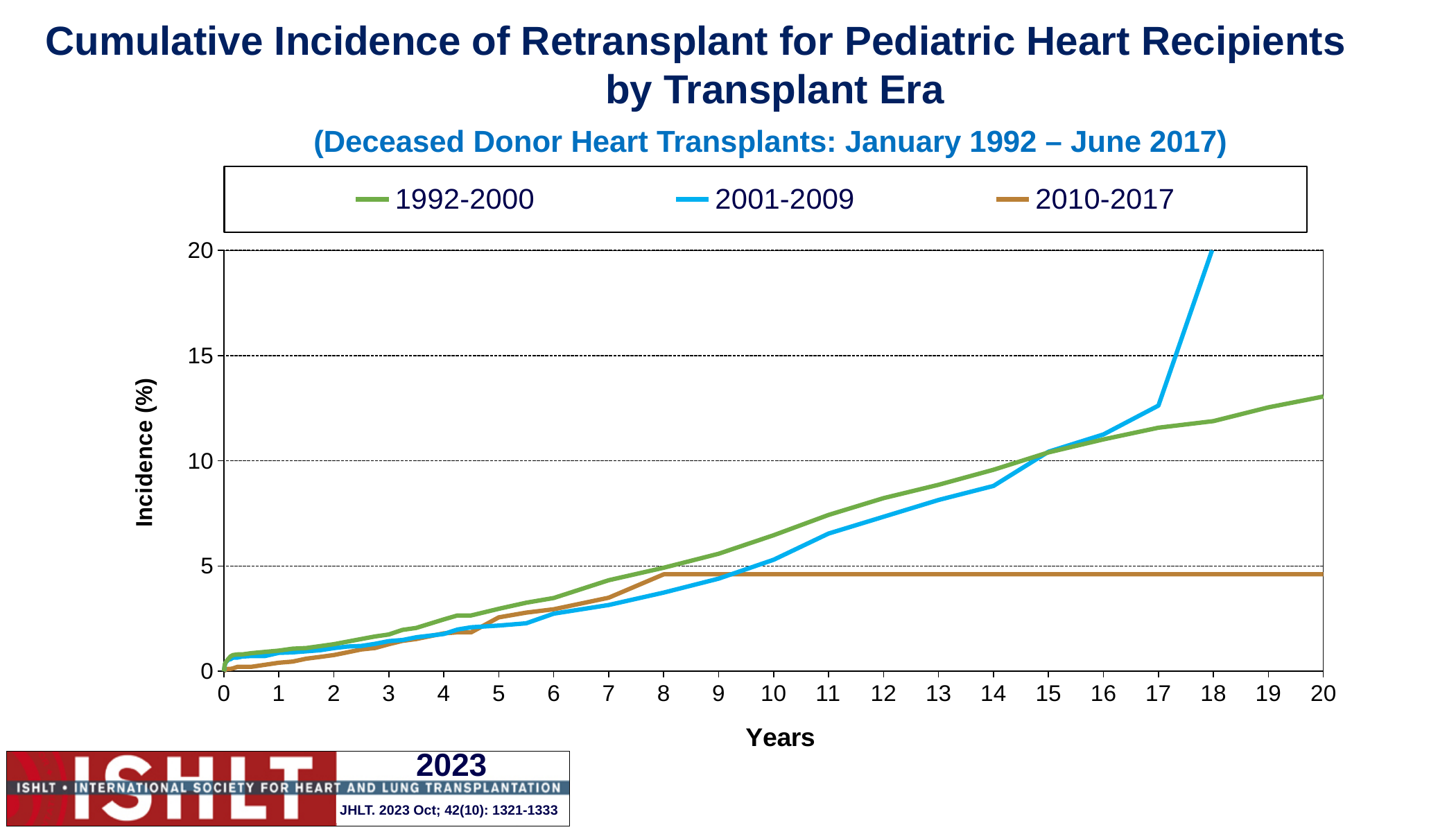
Is the value for the 1992-2000 series at 20 years greater or less than 10? greater Does the 1992-2000 series rise or fall as years increase? Rise What is the label of the y axis? Incidence (%) What are the three transplant eras listed in the legend? 1992-2000, 2001-2009, 2010-2017 Is the value for the 1992-2000 series at 10 years greater or less than 5? greater At 18 years, which series has the higher incidence, 1992-2000 or 2001-2009? 2001-2009 Is the value for the 2001-2009 series at 18 years greater or less than 15? greater Which series reaches the highest incidence value on the chart? 2001-2009 At 12 years, which series has the higher incidence, 1992-2000 or 2010-2017? 1992-2000 What kind of chart is shown on the slide? Line chart How many series does the legend list? 3